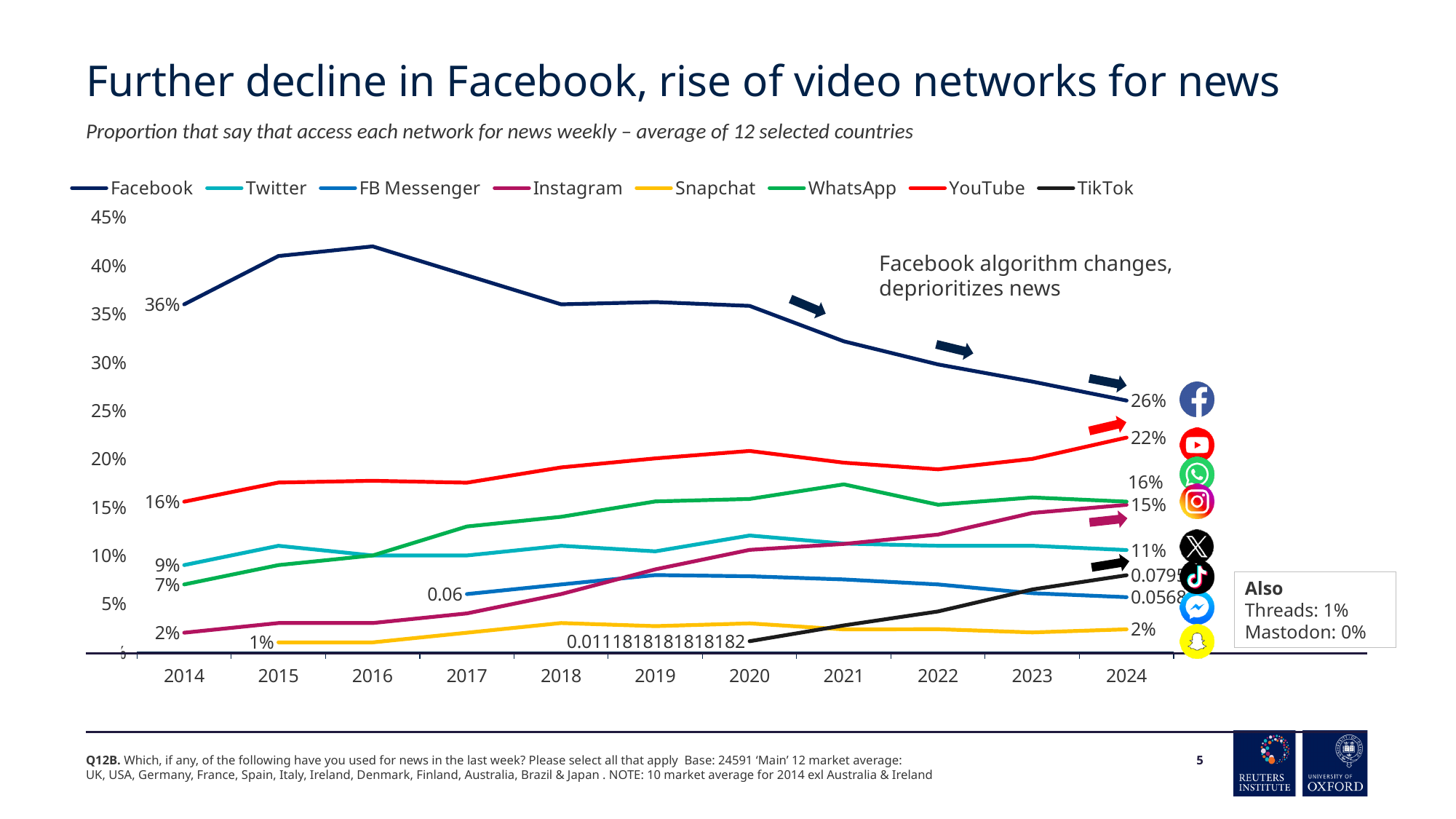
Which network has the lowest value in 2024? Snapchat Which network has the highest value in 2024? Facebook By how many percentage points did Facebook fall between 2014 and 2024? 10 percentage points In 2024, which is larger: YouTube or WhatsApp? YouTube What kind of chart is shown on the slide? Line chart What is the value for Facebook in 2014? 36% What is the value for WhatsApp in 2014? 7% Does the Facebook line rise or fall from 2016 to 2024? Falls What is the value for YouTube in 2024? 22% Is the value for Facebook in 2016 greater or less than 40%? greater What is the value for Facebook in 2024? 26% How many series does the legend list? 8